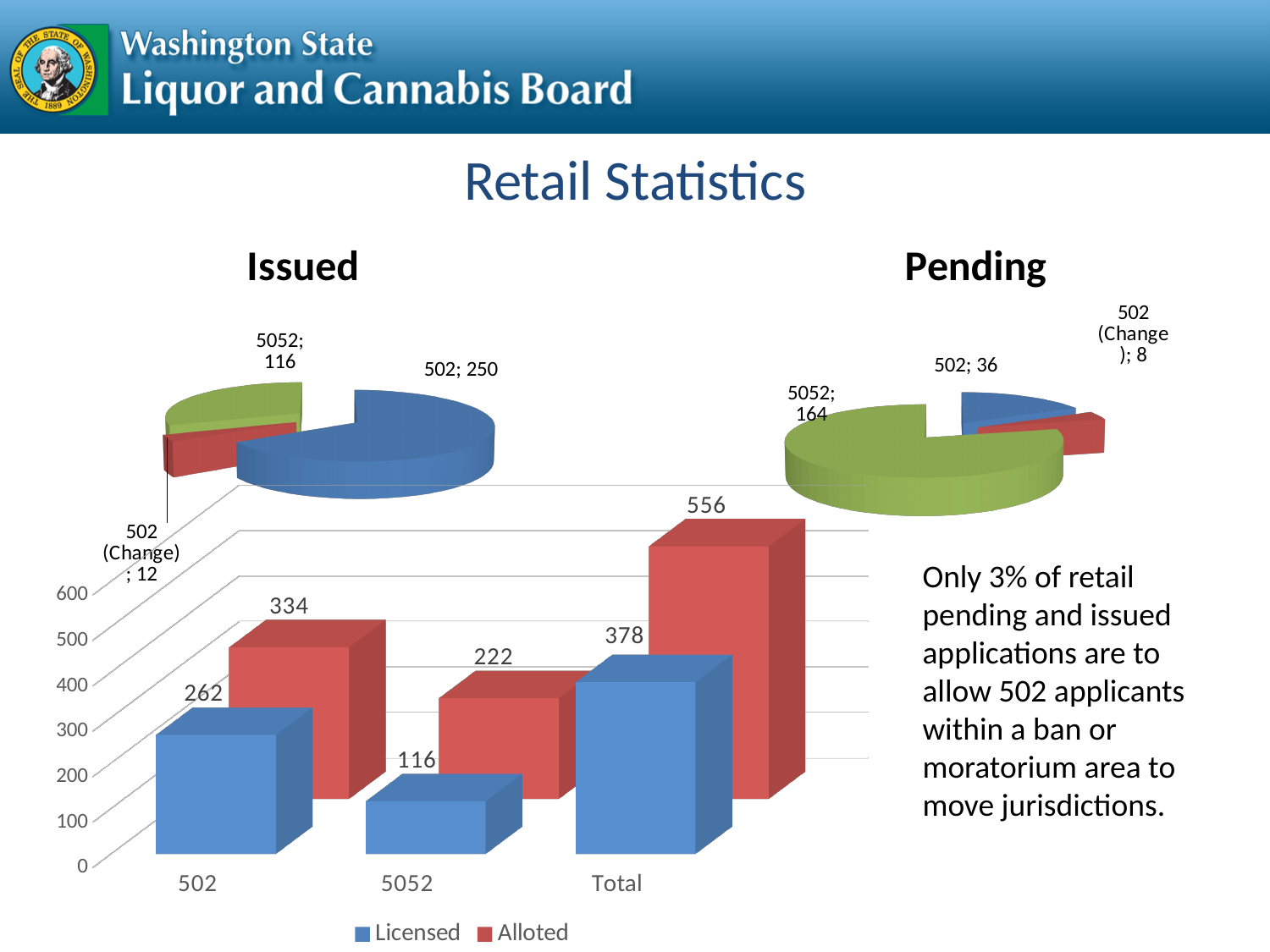
In the Pending pie chart, which category has the smallest value? 502 (Change) In the Pending pie chart, what is the value for 5052? 164 In the Issued pie chart, which category has the largest value? 502 How many series does the legend of the bar chart at the bottom of the slide list? 2 In the bar chart at the bottom of the slide, what is the Alloted value for 5052? 222 What kind of chart is the Pending chart? Pie chart In the Pending pie chart, what is the difference between the values for 5052 and 502? 128 In the bar chart at the bottom of the slide, what is the difference between the Alloted and Licensed values for 502? 72 In the bar chart at the bottom of the slide, what is the Licensed value for Total? 378 In the bar chart at the bottom of the slide, which is larger for 5052: Licensed or Alloted? Alloted In the Issued pie chart, what is the value for 5052? 116 In the Issued pie chart, what is the value for 502? 250